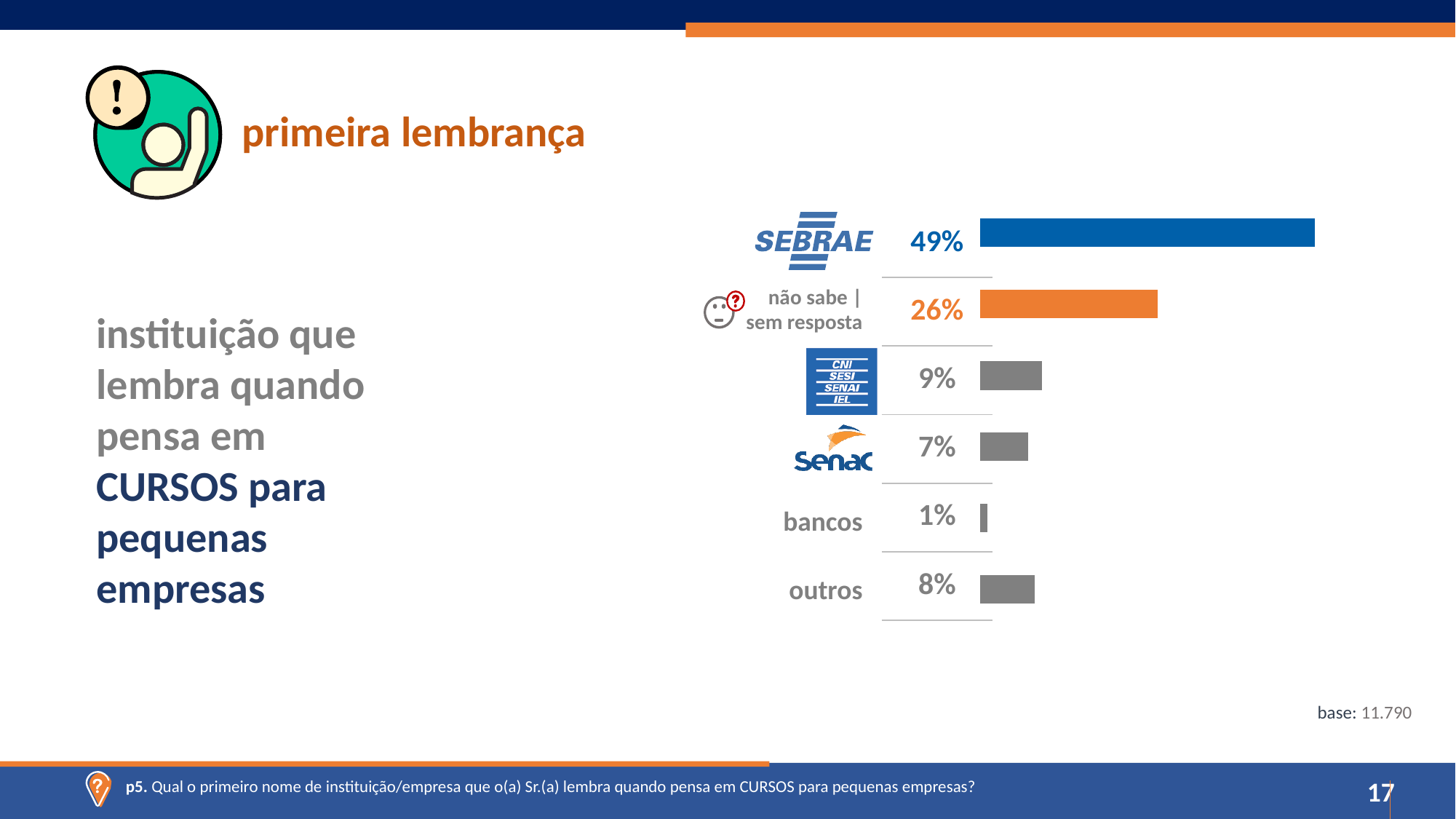
What kind of chart is shown on the slide? bar chart What percentage is shown for SEBRAE? 49% Which is larger, the value for outros or the value for Senac? outros What percentage is shown for bancos? 1% What percentage is shown for outros? 8% Which category has the lowest value? bancos What is the difference between the SEBRAE value and the 'não sabe | sem resposta' value? 23% What percentage is shown for 'não sabe | sem resposta'? 26% How many categories are shown in the chart? 6 What is the base (sample size) shown on the slide? 11.790 Which category has the highest value? SEBRAE What percentage is shown for Senac? 7%